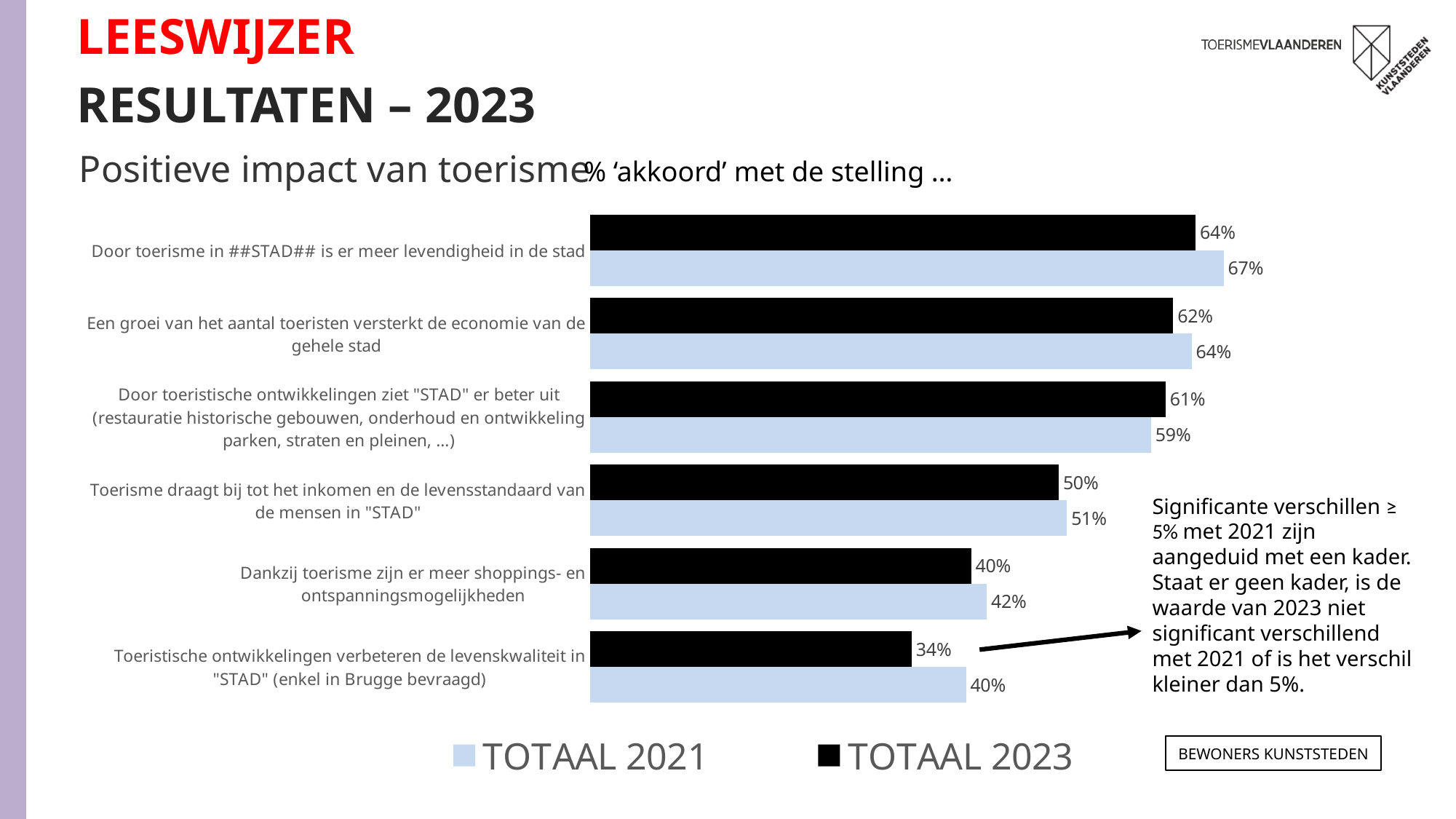
How many series does the legend list? 2 What kind of chart is shown on the slide? Bar chart What is the TOTAAL 2023 value for "Toeristische ontwikkelingen verbeteren de levenskwaliteit in "STAD" (enkel in Brugge bevraagd)"? 34% Which statement has the highest TOTAAL 2021 value? Door toerisme in ##STAD## is er meer levendigheid in de stad What is the TOTAAL 2023 value for "Toerisme draagt bij tot het inkomen en de levensstandaard van de mensen in "STAD""? 50% What is the TOTAAL 2021 value for "Dankzij toerisme zijn er meer shoppings- en ontspanningsmogelijkheden"? 42% How many statements (categories) are shown in the chart? 6 Which statement has the lowest TOTAAL 2023 value? Toeristische ontwikkelingen verbeteren de levenskwaliteit in "STAD" (enkel in Brugge bevraagd) For "Door toeristische ontwikkelingen ziet "STAD" er beter uit", which is larger: the TOTAAL 2021 value or the TOTAAL 2023 value? TOTAAL 2023 What is the TOTAAL 2023 value for "Door toerisme in ##STAD## is er meer levendigheid in de stad"? 64% What is the difference between the TOTAAL 2021 and TOTAAL 2023 values for "Toeristische ontwikkelingen verbeteren de levenskwaliteit in "STAD" (enkel in Brugge bevraagd)"? 6% Which colour represents the TOTAAL 2023 series in the chart? Black